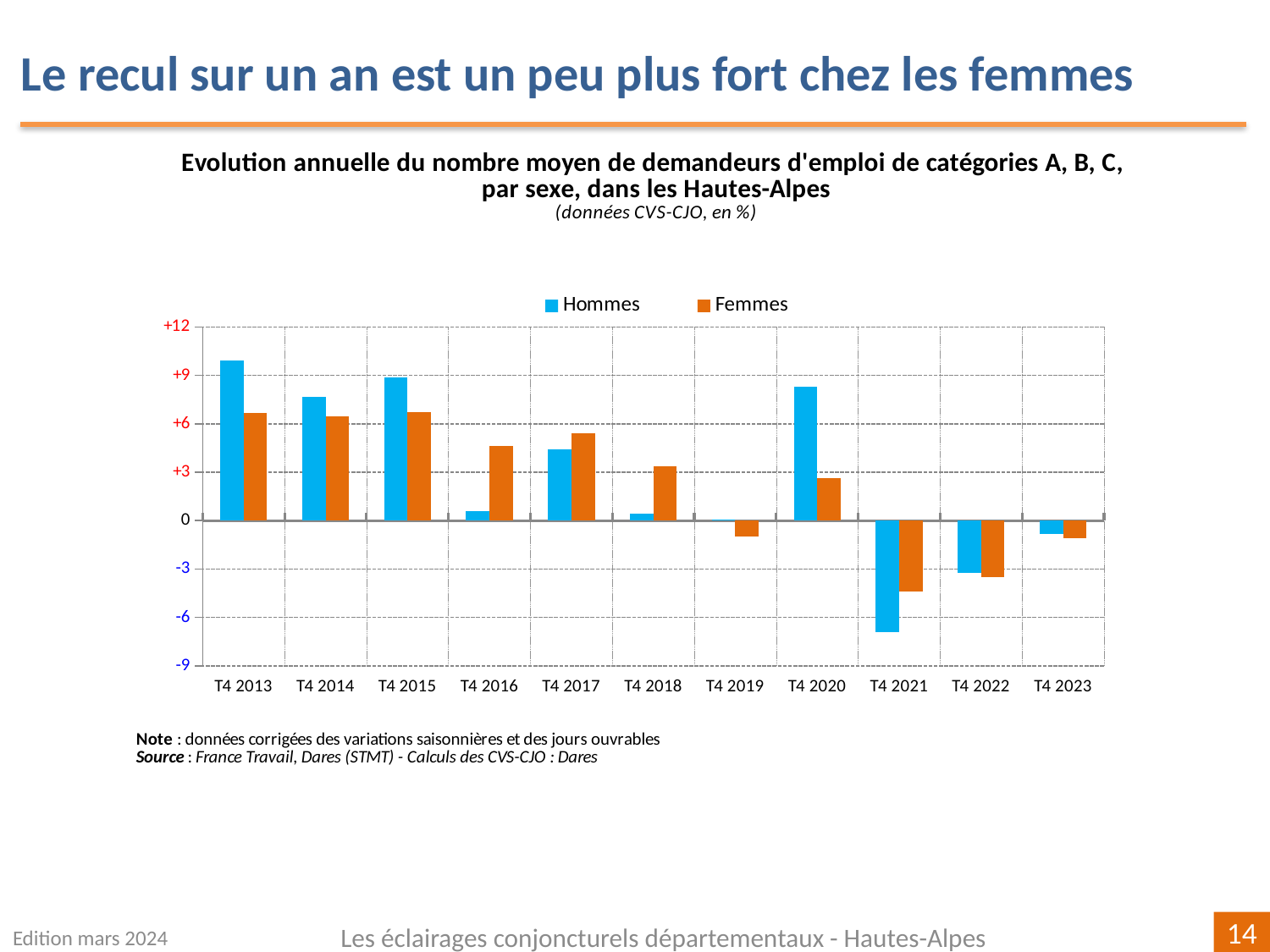
In which period is the Femmes value lowest? T4 2021 How many periods (categories) are shown on the x axis? 11 How many series does the legend list? 2 Is the Femmes value for T4 2017 greater or less than +3? greater In T4 2016, which series has the larger value, Hommes or Femmes? Femmes What kind of chart is shown on the slide? Bar chart In T4 2020, which series has the larger value, Hommes or Femmes? Hommes Which colour represents the Femmes series in the legend? Orange In which period is the Hommes value lowest? T4 2021 In which period is the Hommes value highest? T4 2013 Is the Hommes value for T4 2013 greater or less than +9? greater Is the Hommes value for T4 2021 greater or less than -6? less